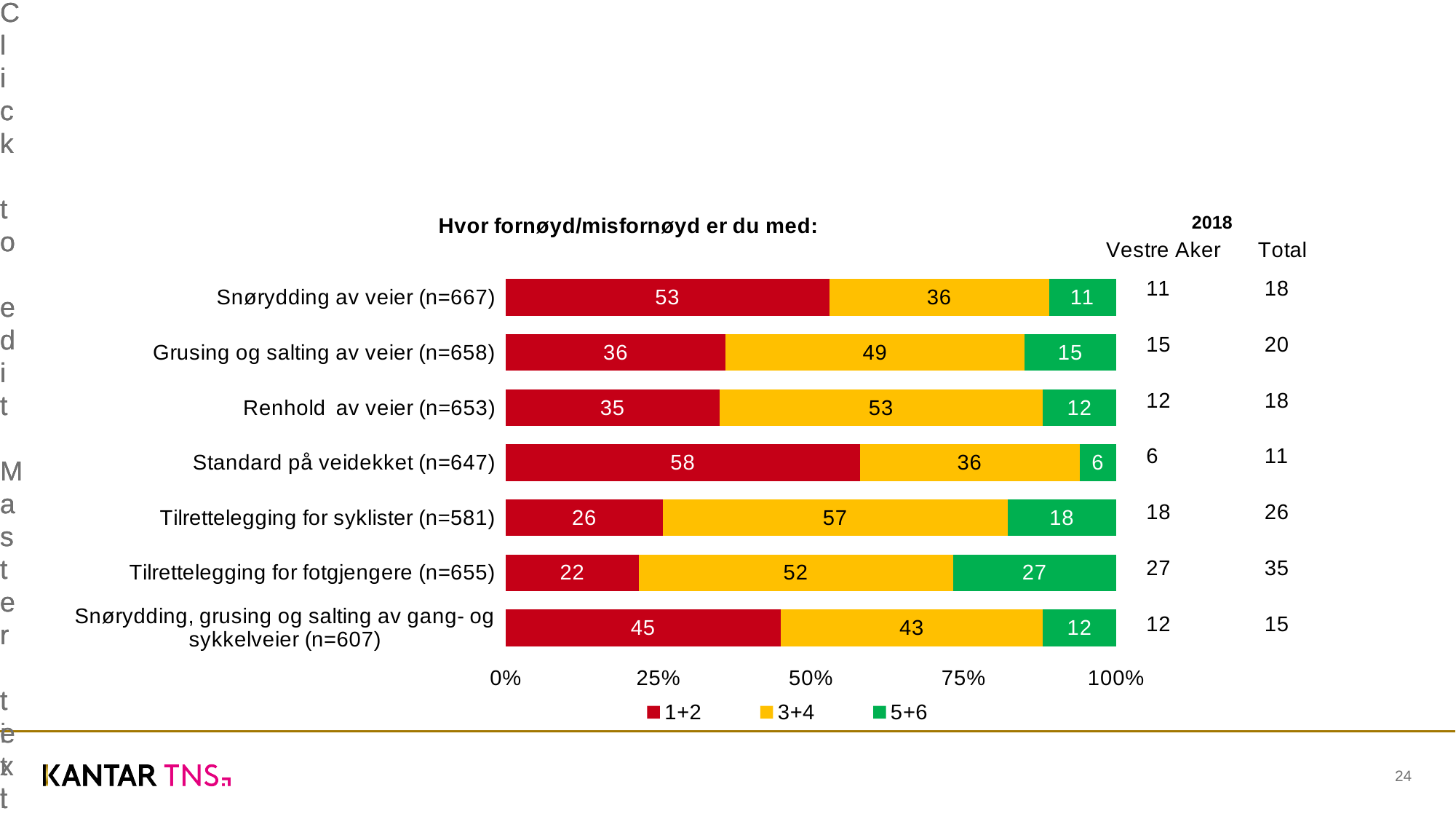
What is the value of the 1+2 segment for Snørydding av veier (n=667)? 53 What is the Total value shown for Tilrettelegging for fotgjengere (n=655) in the 2018 table? 35 Which is larger: the 3+4 value for Renhold av veier (n=653) or the 3+4 value for Grusing og salting av veier (n=658)? Renhold av veier (n=653) What kind of chart is shown on the slide? Stacked bar chart What is the title of the chart? Hvor fornøyd/misfornøyd er du med: How many categories (questions) are plotted in the chart? 7 What is the difference between the 1+2 values for Snørydding av veier (n=667) and Grusing og salting av veier (n=658)? 17 What is the value of the 5+6 segment for Tilrettelegging for fotgjengere (n=655)? 27 How many series does the legend list? 3 Which category has the lowest 5+6 value? Standard på veidekket (n=647) Which category has the highest 1+2 value? Standard på veidekket (n=647) What is the value of the 3+4 segment for Tilrettelegging for syklister (n=581)? 57